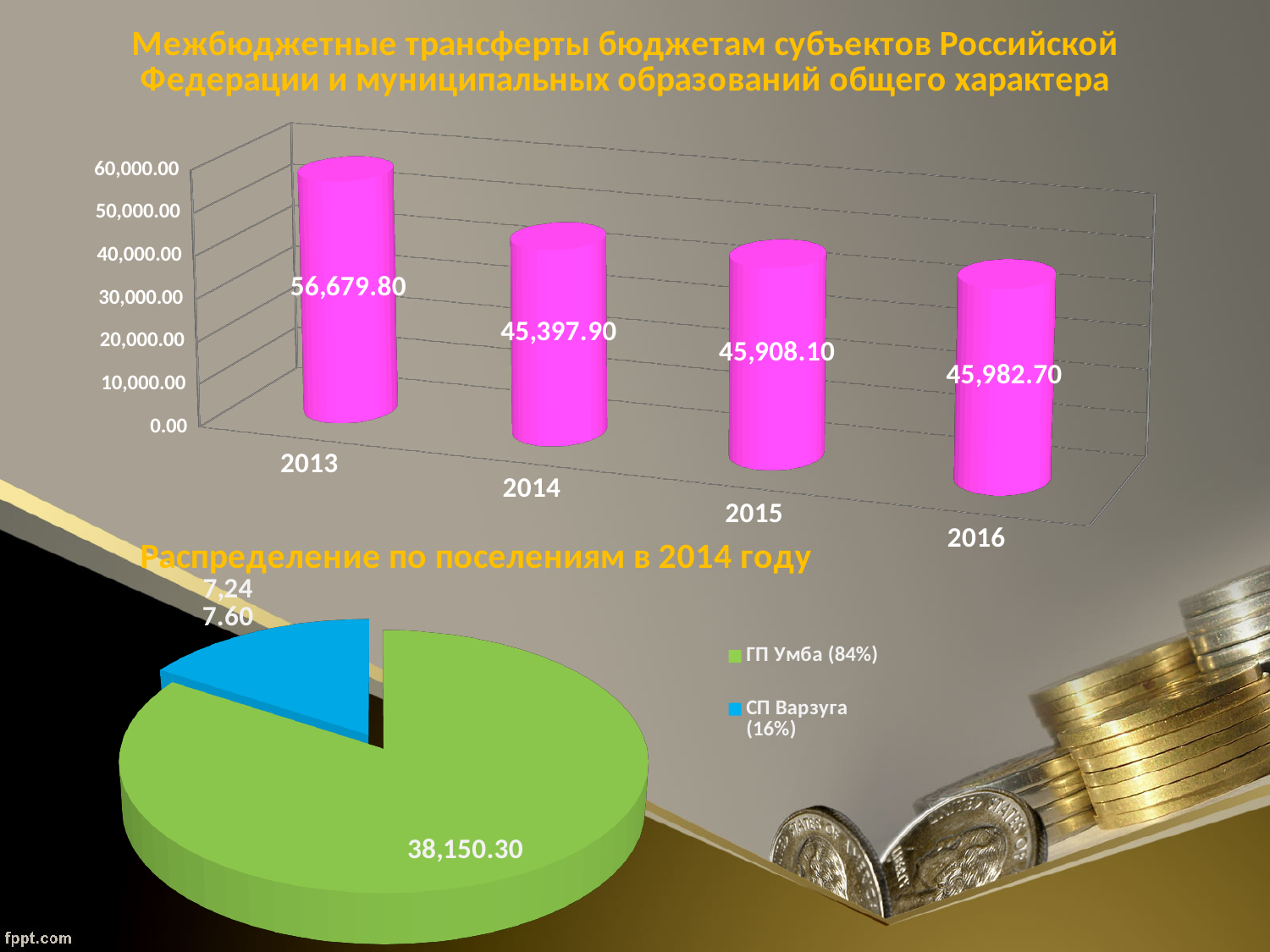
On the top chart, which year has the lowest value? 2014 On the pie chart 'Распределение по поселениям в 2014 году', what is the value for ГП Умба? 38,150.30 On the top chart, how many years are shown? 4 On the top chart, what is the value for 2013? 56,679.80 On the top chart, what is the value for 2014? 45,397.90 What kind of chart is the top chart? bar chart On the top chart, what is the difference between the values for 2013 and 2014? 11,281.90 On the top chart, what is the value for 2016? 45,982.70 How many entries does the legend of the pie chart 'Распределение по поселениям в 2014 году' list? 2 On the top chart, which is larger: the value for 2015 or the value for 2014? 2015 On the top chart, which year has the highest value? 2013 On the pie chart 'Распределение по поселениям в 2014 году', what share does ГП Умба have? 84%